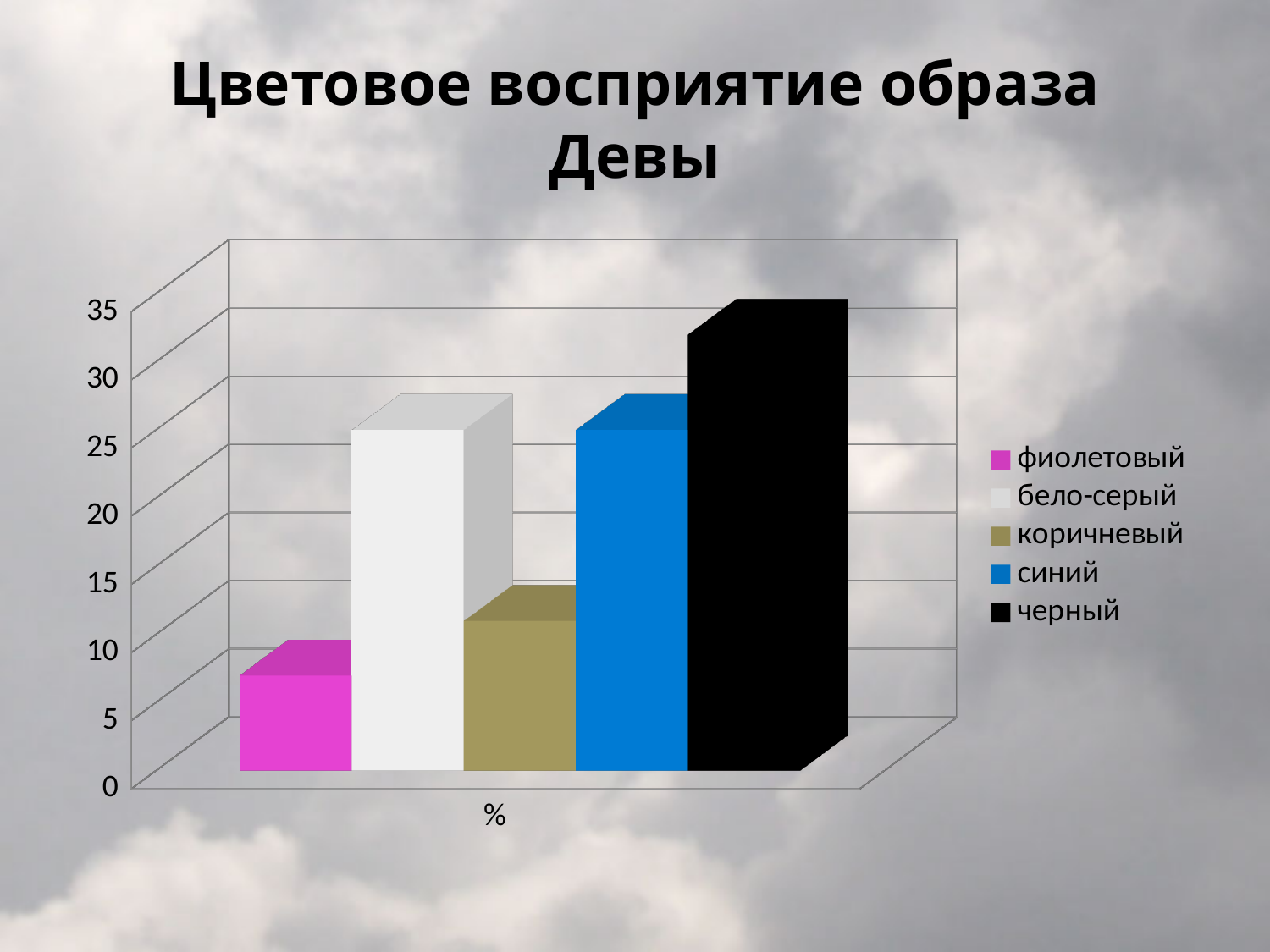
Is the value for черный greater or less than 30? greater What kind of chart is shown on the slide? bar chart Is the value for бело-серый greater or less than 20? greater What is the title of the chart? Цветовое восприятие образа Девы Is the value for коричневый greater or less than 15? less Which is larger, the value for коричневый or the value for фиолетовый? коричневый How many series does the legend list? 5 Which series has the lowest bar? фиолетовый Which is larger, the value for черный or the value for синий? черный Which series has the highest bar? черный What label is shown on the horizontal axis of the chart? %